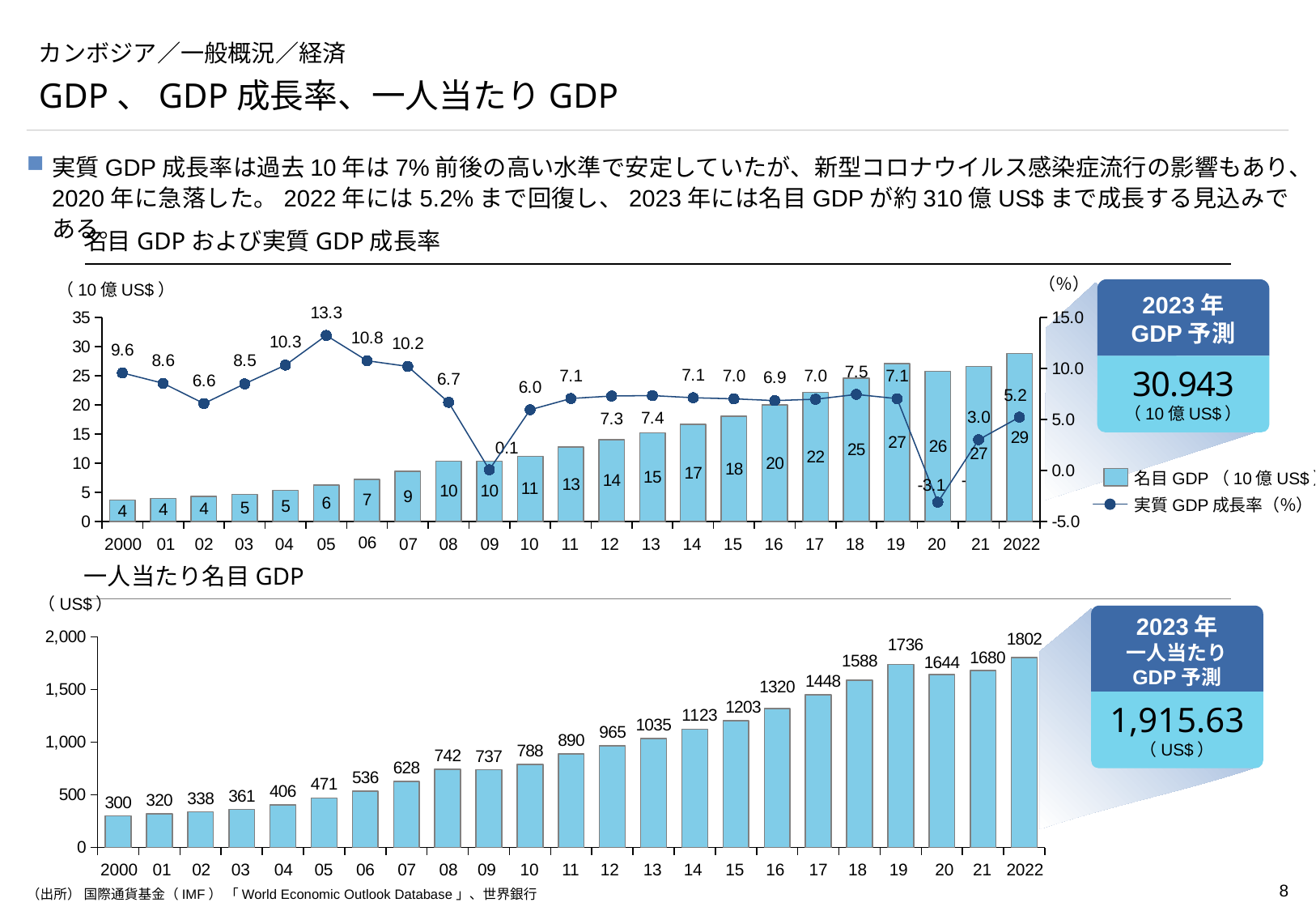
In the bottom chart (一人当たり名目GDP), which year has the highest value? 2022 In the top chart (名目GDPおよび実質GDP成長率), what is the real GDP growth rate shown for 2020? -3.1 In the top chart (名目GDPおよび実質GDP成長率), which year has the lowest real GDP growth rate? 2020 How many series does the legend of the top chart (名目GDPおよび実質GDP成長率) list? 2 In the top chart (名目GDPおよび実質GDP成長率), what is the real GDP growth rate shown for 2009? 0.1 In the top chart (名目GDPおよび実質GDP成長率), what is the nominal GDP value shown for 2022? 29 What kind of chart is the bottom chart (一人当たり名目GDP)? Bar chart In the bottom chart (一人当たり名目GDP), which year has the larger value, 2019 or 2020? 2019 In the top chart (名目GDPおよび実質GDP成長率), which year has the highest real GDP growth rate? 2005 How many years are plotted in the bottom chart (一人当たり名目GDP)? 23 In the bottom chart (一人当たり名目GDP), what is the difference between the 2022 value and the 2000 value? 1502 In the bottom chart (一人当たり名目GDP), what is the value shown for 2019? 1736